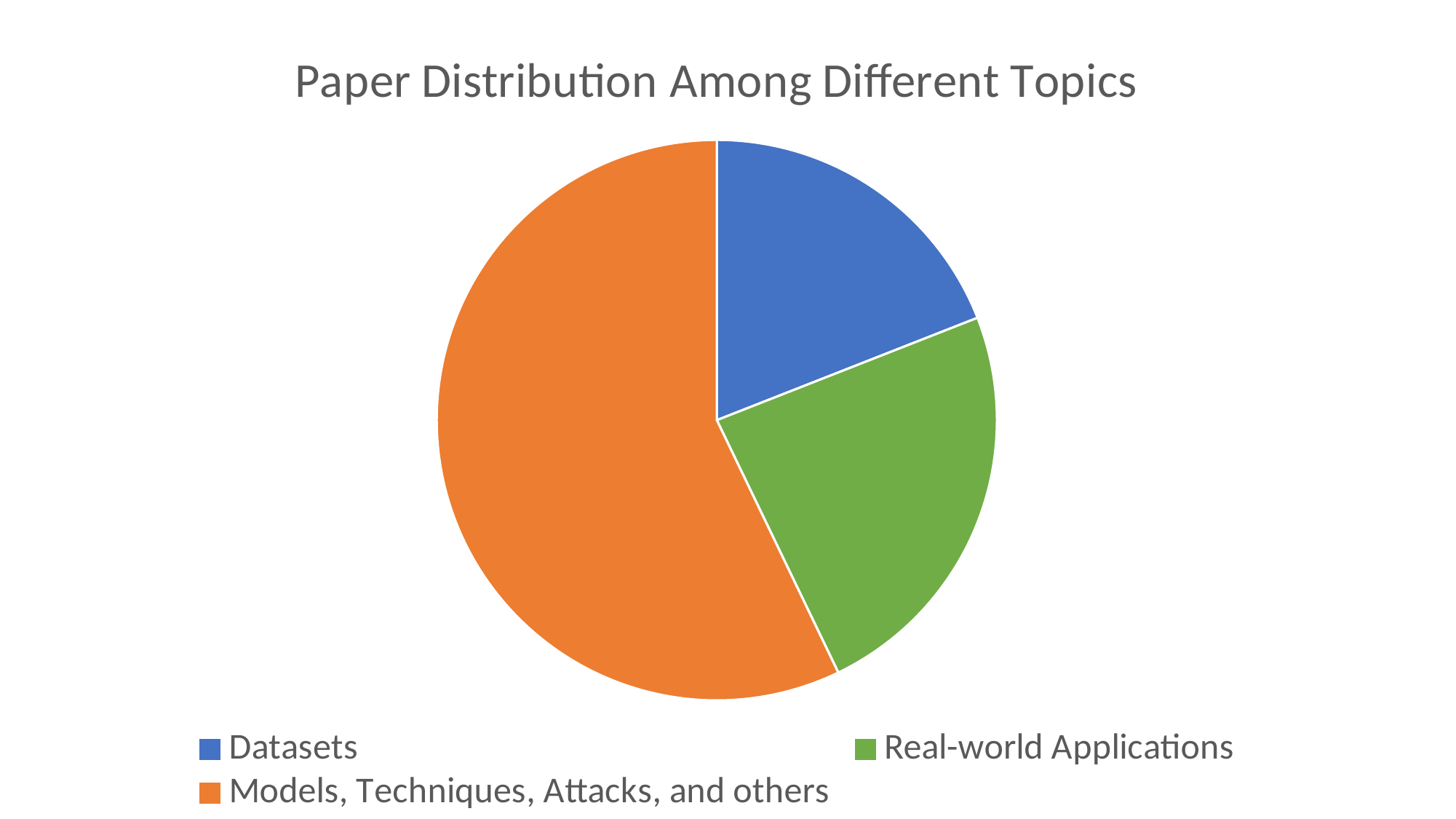
Which topic has the smallest share of papers? Datasets How many slices does the pie chart have? 3 Which slice is larger, Real-world Applications or Models, Techniques, Attacks, and others? Models, Techniques, Attacks, and others What is the title of the chart? Paper Distribution Among Different Topics What kind of chart is shown on the slide? pie chart Which colour represents Real-world Applications in the pie chart? green How many entries does the legend list? 3 Does the Models, Techniques, Attacks, and others slice take up more or less than half of the pie? more Which slice is larger, Datasets or Real-world Applications? Real-world Applications Which topic has the largest share of papers? Models, Techniques, Attacks, and others